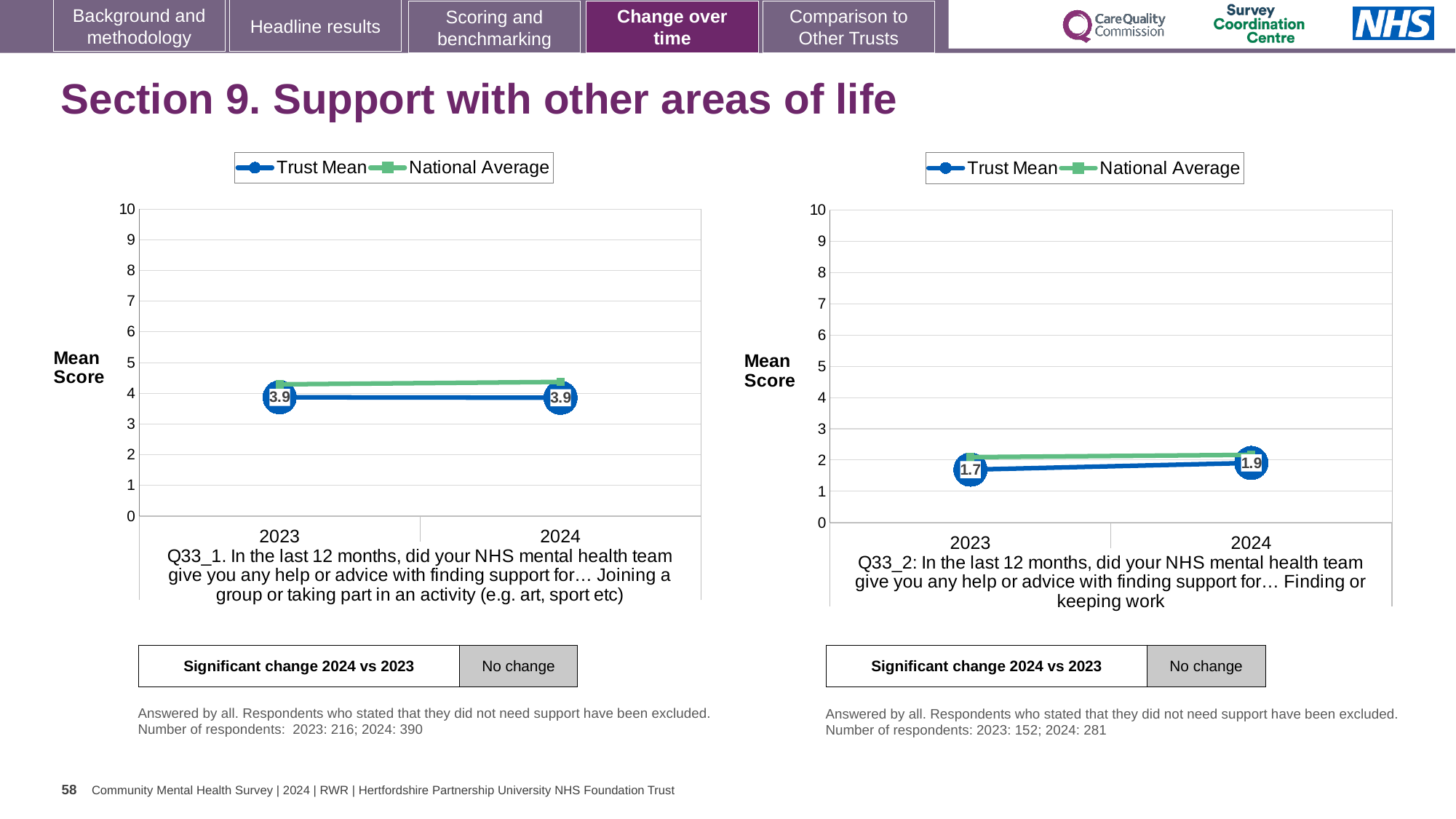
What kind of chart is the right chart (Q33_2)? line chart How many series does the legend of the left chart list? 2 In the right chart (Q33_2), which year has the higher Trust Mean, 2023 or 2024? 2024 In the left chart (Q33_1), which series is higher in 2023, Trust Mean or National Average? National Average In the left chart (Q33_1), what is the Trust Mean for 2023? 3.9 In the right chart (Q33_2), is the National Average for 2024 greater or less than 3? less In the right chart (Q33_2), what is the difference between the Trust Mean for 2024 and 2023? 0.2 In the left chart (Q33_1), what is the Trust Mean for 2024? 3.9 In the right chart (Q33_2), does the Trust Mean rise or fall from 2023 to 2024? rise In the left chart (Q33_1), is the National Average for 2023 greater or less than 4? greater In the right chart (Q33_2), what is the Trust Mean for 2024? 1.9 In the right chart (Q33_2), what is the Trust Mean for 2023? 1.7